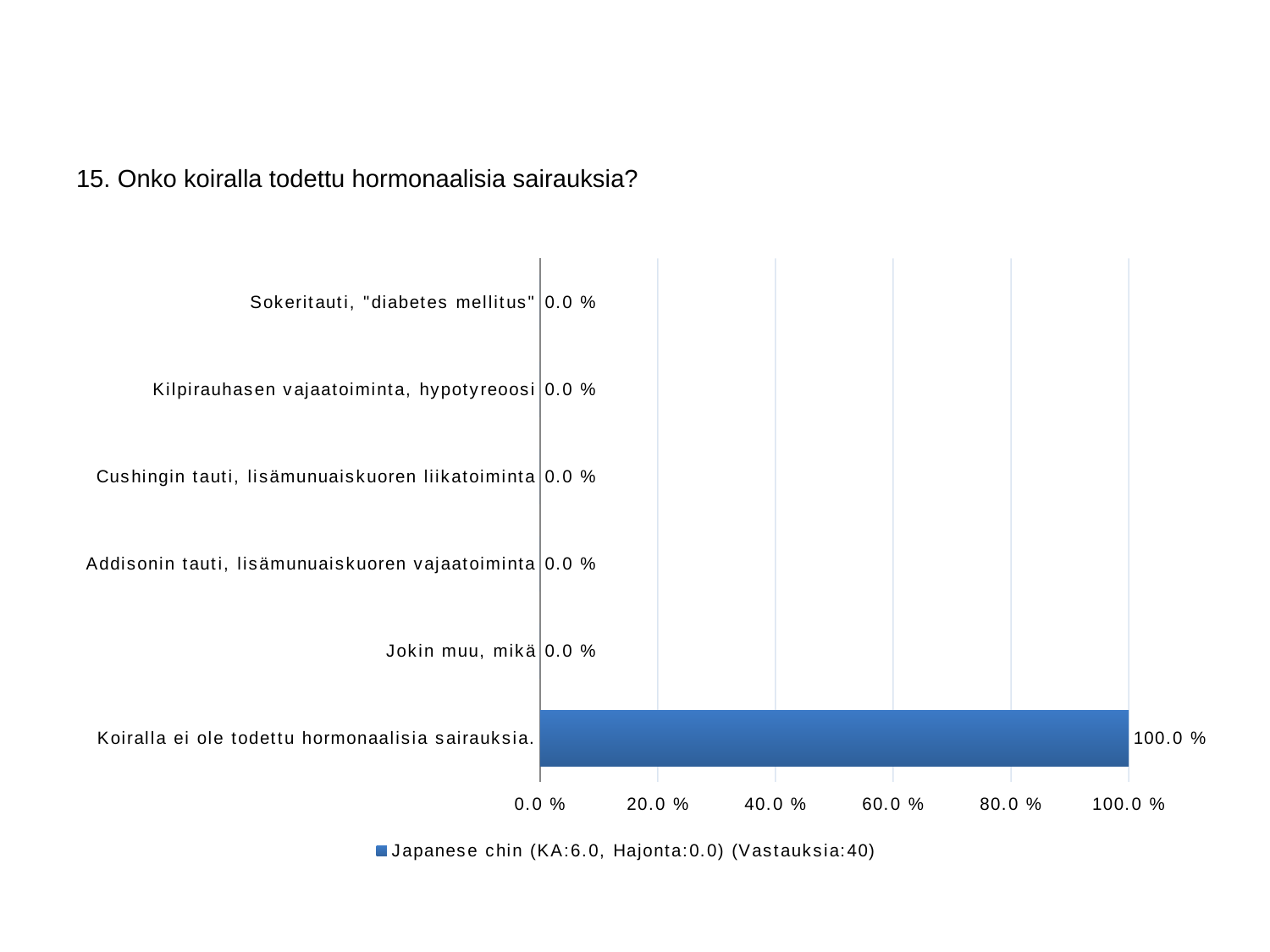
Is the value for "Koiralla ei ole todettu hormonaalisia sairauksia." greater or less than 80.0 %? greater What kind of chart is shown on the slide? bar chart How many categories are shown on the chart? 6 How many series does the legend list? 1 What is the difference between the value for "Koiralla ei ole todettu hormonaalisia sairauksia." and the value for "Addisonin tauti, lisämunuaiskuoren vajaatoiminta"? 100.0 % What is the value for "Koiralla ei ole todettu hormonaalisia sairauksia."? 100.0 % What is the title of the chart? 15. Onko koiralla todettu hormonaalisia sairauksia? What is the value for "Jokin muu, mikä"? 0.0 % What is the value for "Sokeritauti, "diabetes mellitus""? 0.0 % Which category has the highest value? Koiralla ei ole todettu hormonaalisia sairauksia. What is the value for "Cushingin tauti, lisämunuaiskuoren liikatoiminta"? 0.0 % Which is larger: the value for "Koiralla ei ole todettu hormonaalisia sairauksia." or the value for "Kilpirauhasen vajaatoiminta, hypotyreoosi"? Koiralla ei ole todettu hormonaalisia sairauksia.